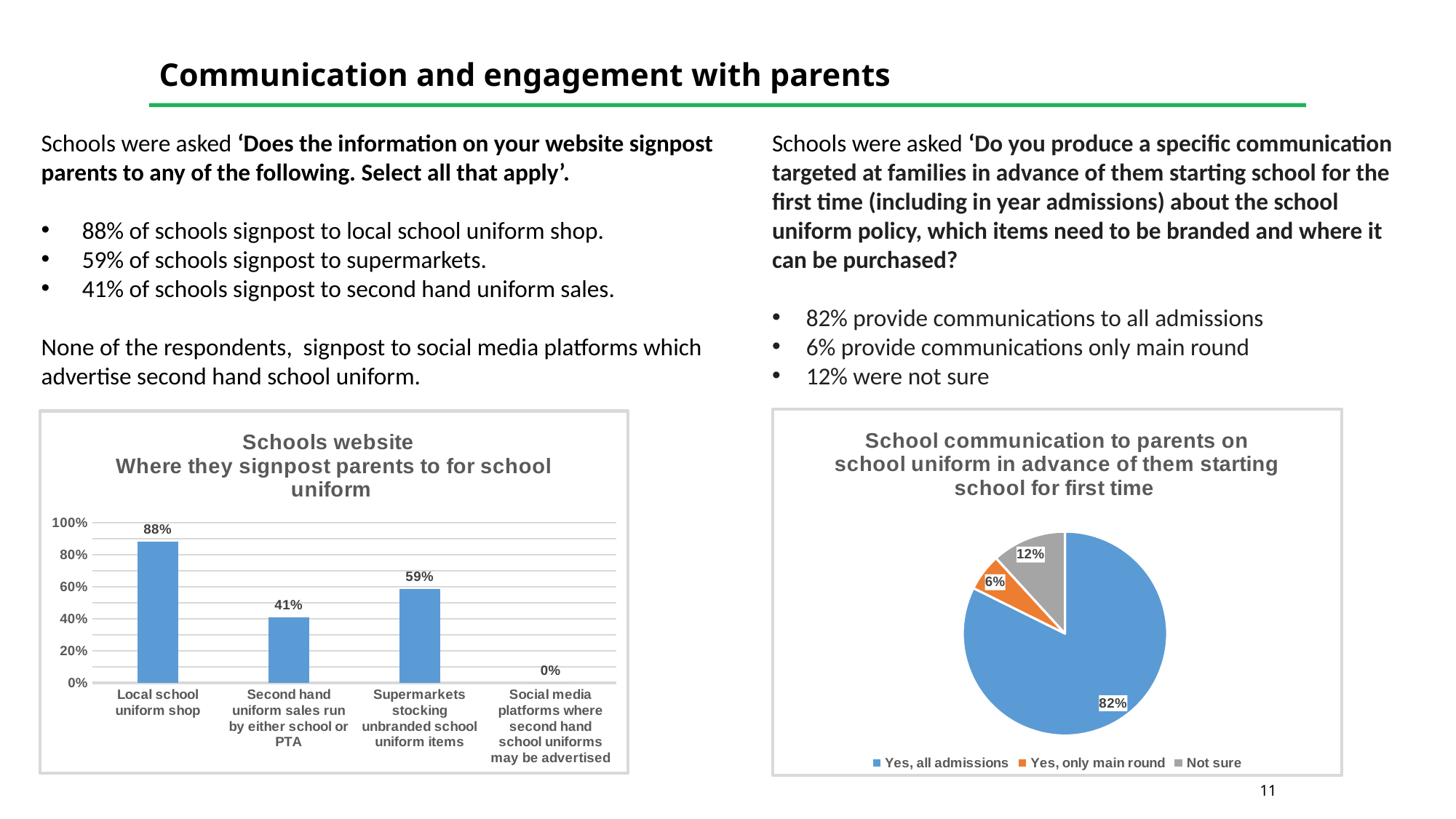
In the 'Schools website' bar chart, what is the value for Local school uniform shop? 88% What kind of chart is the chart on the left of the slide? Bar chart In the 'Schools website' bar chart, what is the difference between the values for Local school uniform shop and Second hand uniform sales run by either school or PTA? 47% In the pie chart on the right, what share is 'Yes, all admissions'? 82% In the 'Schools website' bar chart, which is larger: the value for Supermarkets stocking unbranded school uniform items or Second hand uniform sales run by either school or PTA? Supermarkets stocking unbranded school uniform items In the pie chart on the right, which slice is the smallest? Yes, only main round How many entries does the legend of the pie chart on the right list? 3 In the pie chart on the right, what is the value for 'Not sure'? 12% In the 'Schools website' bar chart, what is the value for Supermarkets stocking unbranded school uniform items? 59% In the 'Schools website' bar chart, which category has the highest value? Local school uniform shop How many categories are shown in the 'Schools website' bar chart? 4 In the 'Schools website' bar chart, which category has the lowest value? Social media platforms where second hand school uniforms may be advertised